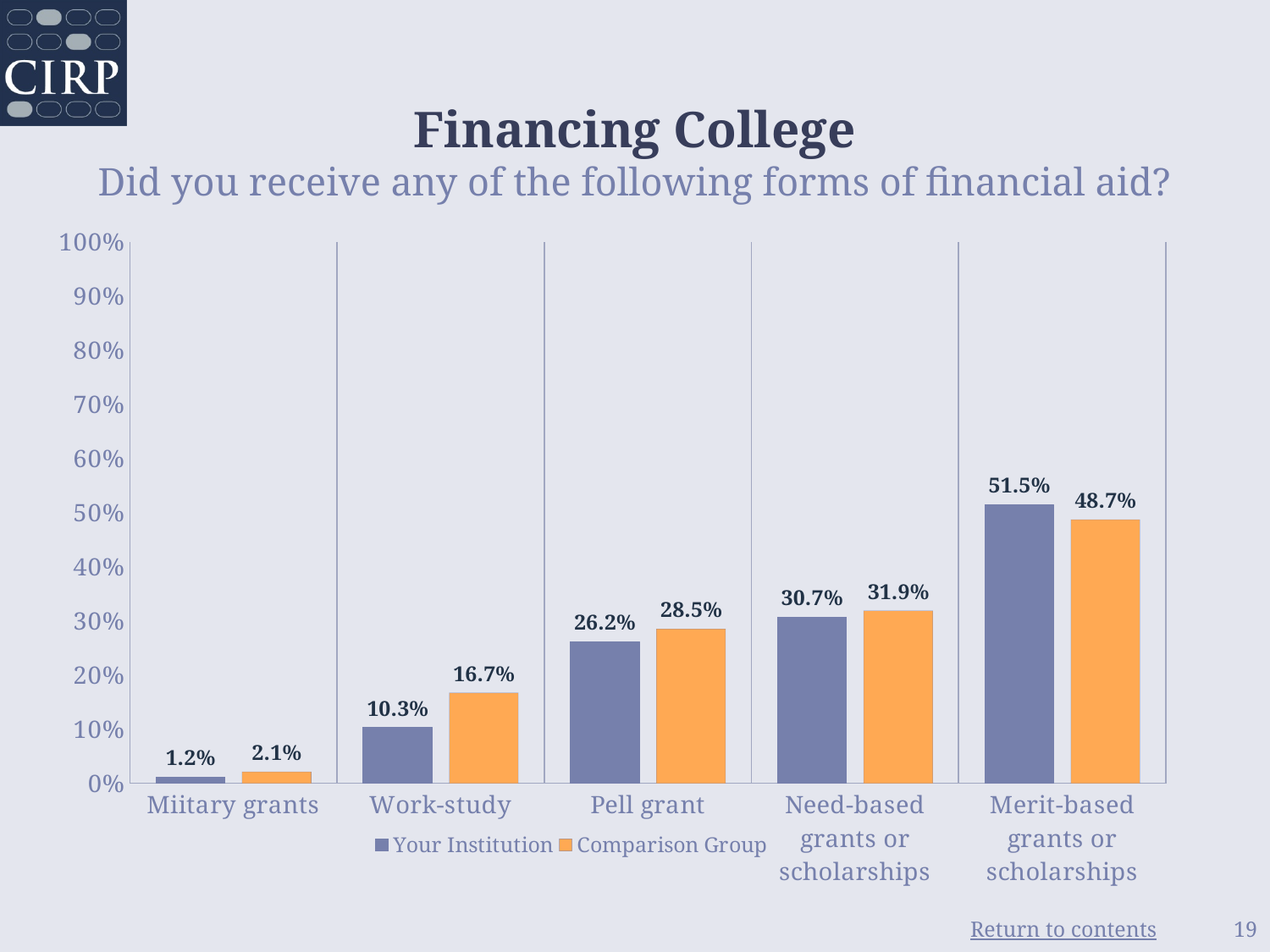
What is the difference between Comparison Group and Your Institution for Work-study? 6.4% What is the value for Your Institution for Pell grant? 26.2% How many categories are shown on the x axis? 5 Which category has the lowest value for Your Institution? Miitary grants What kind of chart is shown on the slide? bar chart Is the value for Your Institution for Merit-based grants or scholarships greater or less than 50%? greater Which category has the highest value for Comparison Group? Merit-based grants or scholarships What is the value for Your Institution for Merit-based grants or scholarships? 51.5% For Need-based grants or scholarships, which is larger: Your Institution or Comparison Group? Comparison Group What is the title of the chart? Financing College What is the value for Comparison Group for Work-study? 16.7% How many series does the legend list? 2